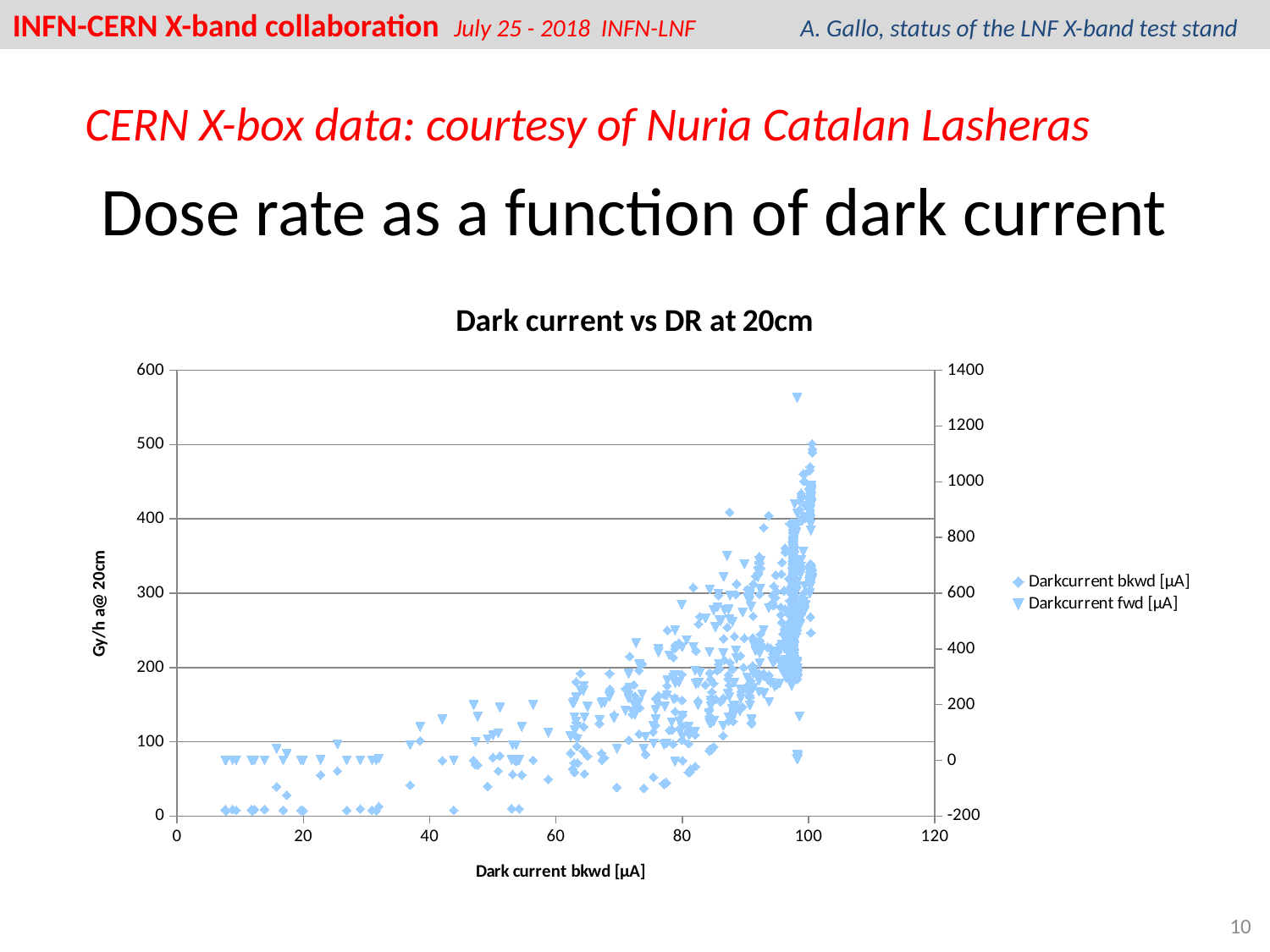
Do the plotted dose rate values generally rise or fall as dark current increases along the x axis? Rise How many series does the legend list? 2 What is the label of the x axis? Dark current bkwd [µA] What kind of chart is shown on the slide? Scatter chart What is the title of the chart? Dark current vs DR at 20cm